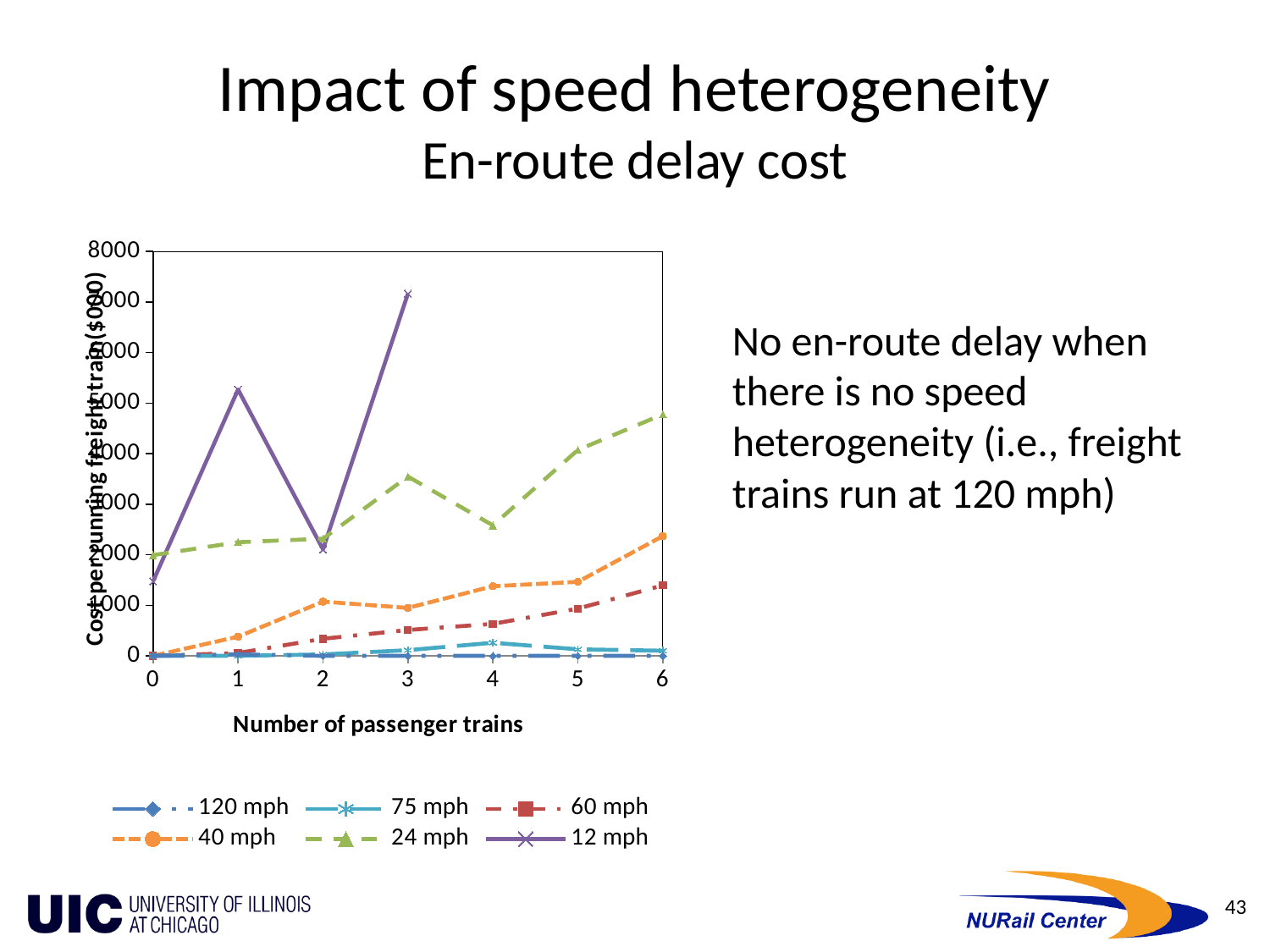
How many series does the legend list? 6 At 3 passenger trains, which series has the larger cost, 12 mph or 24 mph? 12 mph Is the value for 24 mph at 6 passenger trains greater or less than 3000? greater At 4 passenger trains, which series has the larger cost, 40 mph or 60 mph? 40 mph Does the cost for the 60 mph series rise or fall as the number of passenger trains increases? rises How many values of 'Number of passenger trains' are plotted along the x axis? 7 What kind of chart is shown on the slide? line chart Which series has the lowest cost across all numbers of passenger trains? 120 mph What is the title of the x axis? Number of passenger trains Is the value for 12 mph at 3 passenger trains greater or less than 5000? greater Is the value for 60 mph at 6 passenger trains greater or less than 2000? less Which series has the highest cost at 6 passenger trains? 24 mph